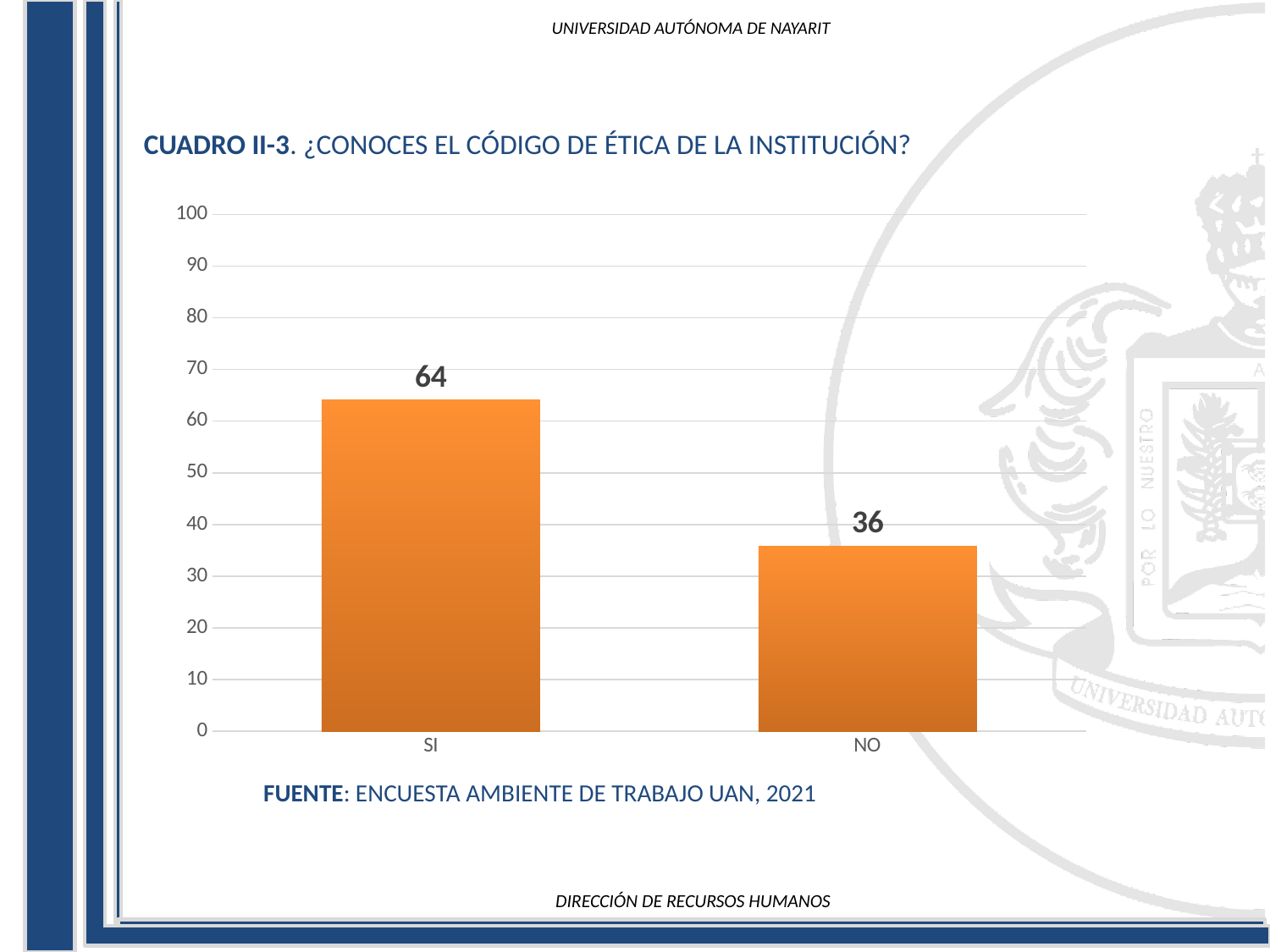
What is the title of the chart? CUADRO II-3. ¿CONOCES EL CÓDIGO DE ÉTICA DE LA INSTITUCIÓN? Is the value for SI greater or less than 60? greater What is the value for SI? 64 Which is larger, the value for SI or the value for NO? SI Which category has the lowest value? NO Is the value for NO greater or less than 40? less What kind of chart is shown on the slide? bar chart What is the value for NO? 36 What is the difference between the values for SI and NO? 28 What is the source cited below the chart? ENCUESTA AMBIENTE DE TRABAJO UAN, 2021 Which category has the highest value? SI How many categories are shown on the x axis? 2